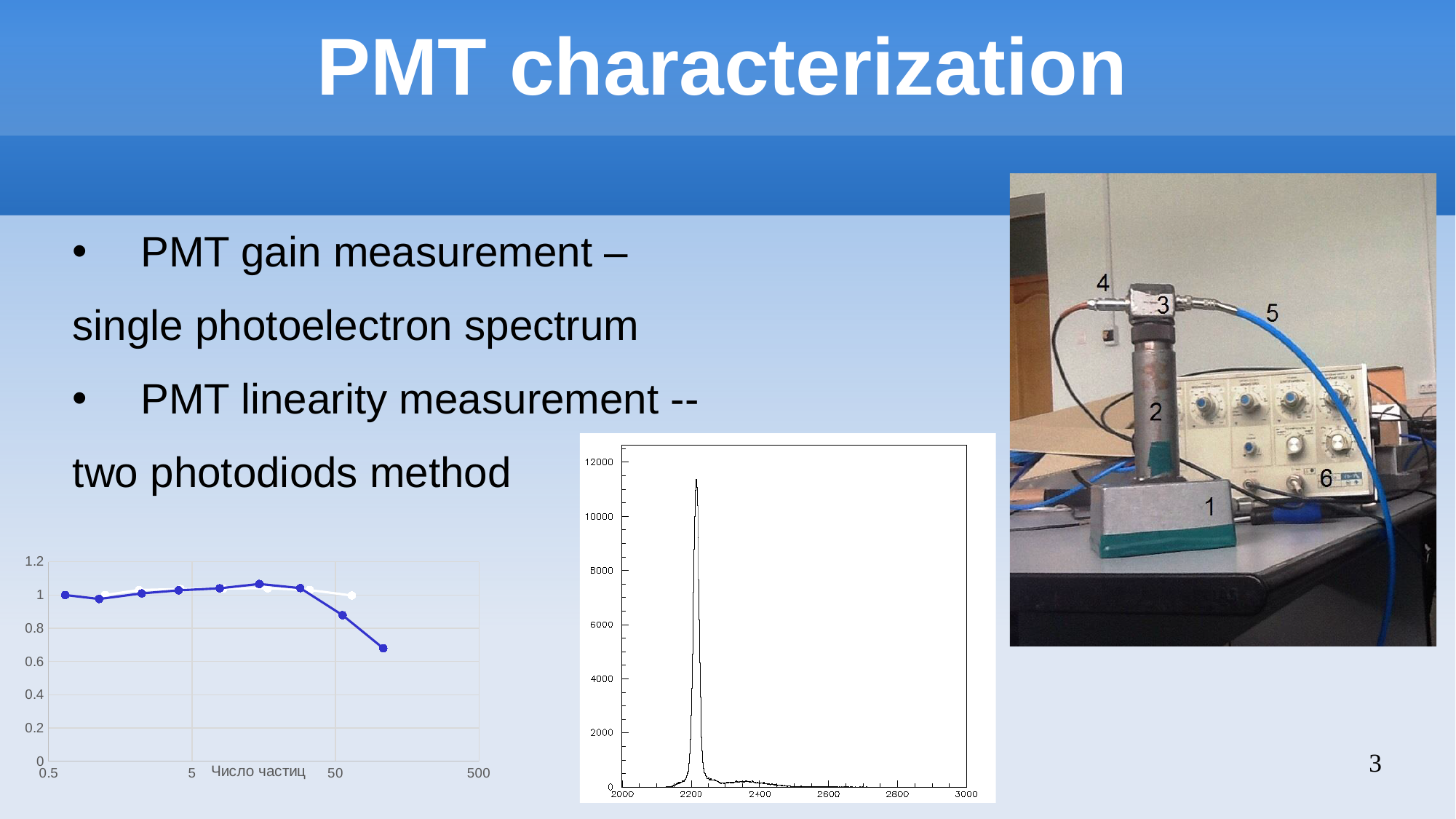
In the middle chart, does the curve rise or fall between x = 2200 and x = 2400? fall What kind of chart is the bottom-left chart with the x-axis labelled "Число частиц"? line chart In the middle chart (x-axis from 2000 to 3000), is the peak value greater or less than 12000? less In the bottom-left chart (x-axis "Число частиц"), does the blue series rise or fall over its last three points? fall In the bottom-left chart (x-axis "Число частиц"), how many data points does the blue series have? 9 In the bottom-left chart (x-axis "Число частиц"), is the value of the rightmost blue point greater or less than 0.8? less In the bottom-left chart (x-axis "Число частиц"), what is the highest tick value shown on the y-axis? 1.2 In the middle chart (x-axis from 2000 to 3000), is the peak value greater or less than 10000? greater In the bottom-left chart, what is the label on the x-axis? Число частиц